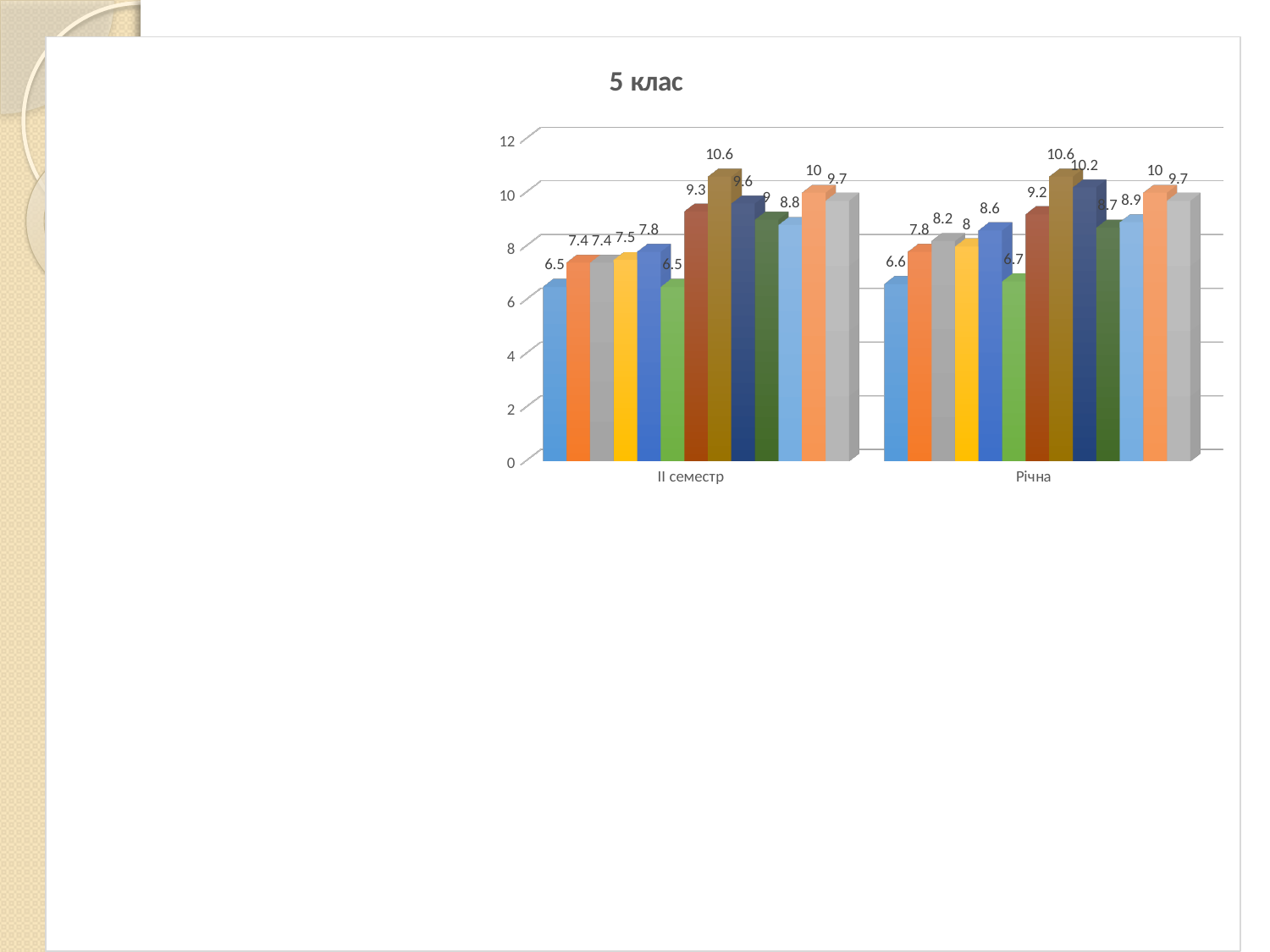
What is the value of the leftmost bar in the Річна group? 6.6 What is the title of the chart? 5 клас What is the highest value labelled in the ІІ семестр group? 10.6 Which is larger: the leftmost bar in ІІ семестр or the leftmost bar in Річна? Річна What is the value of the leftmost bar in the ІІ семестр group? 6.5 How many categories are shown on the x axis? 2 What is the lowest value labelled in the ІІ семестр group? 6.5 Is the tallest bar in the Річна group greater or less than 10? greater What kind of chart is shown on the slide? bar chart What is the lowest value labelled in the Річна group? 6.6 What is the difference between the highest and lowest labelled values in the ІІ семестр group? 4.1 What is the highest value labelled in the Річна group? 10.6